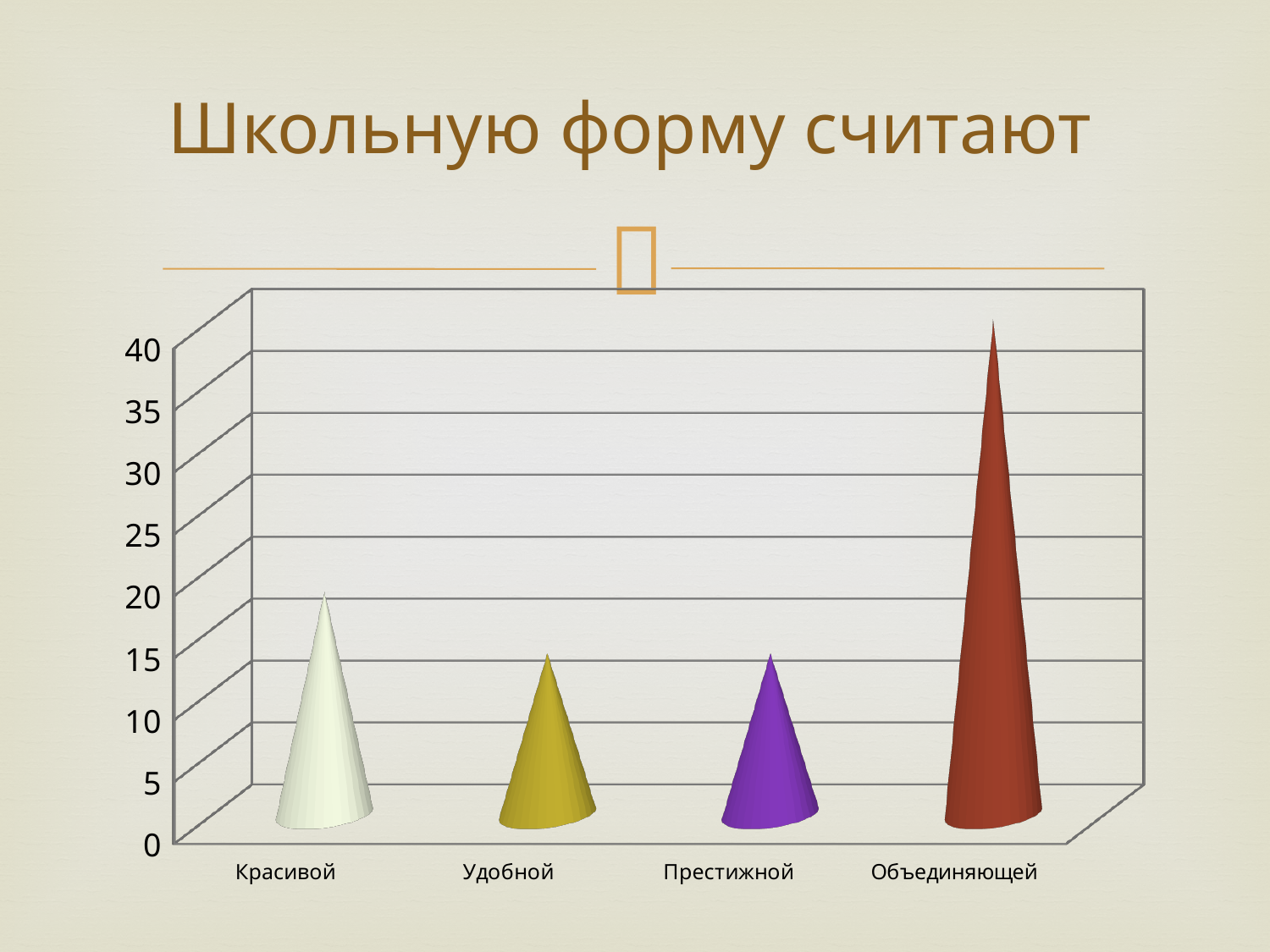
Which is larger, the value for Красивой or the value for Удобной? Красивой How many categories are shown on the x axis of the chart? 4 Which is larger, the value for Объединяющей or the value for Красивой? Объединяющей What kind of chart is shown on the slide? bar chart Is the value for Объединяющей greater or less than 30? greater Is the value for Престижной greater or less than 25? less Is the value for Красивой greater or less than 30? less Which category has the highest value in the chart? Объединяющей What is the title of the chart on the slide? Школьную форму считают What colour is the bar for Объединяющей? red